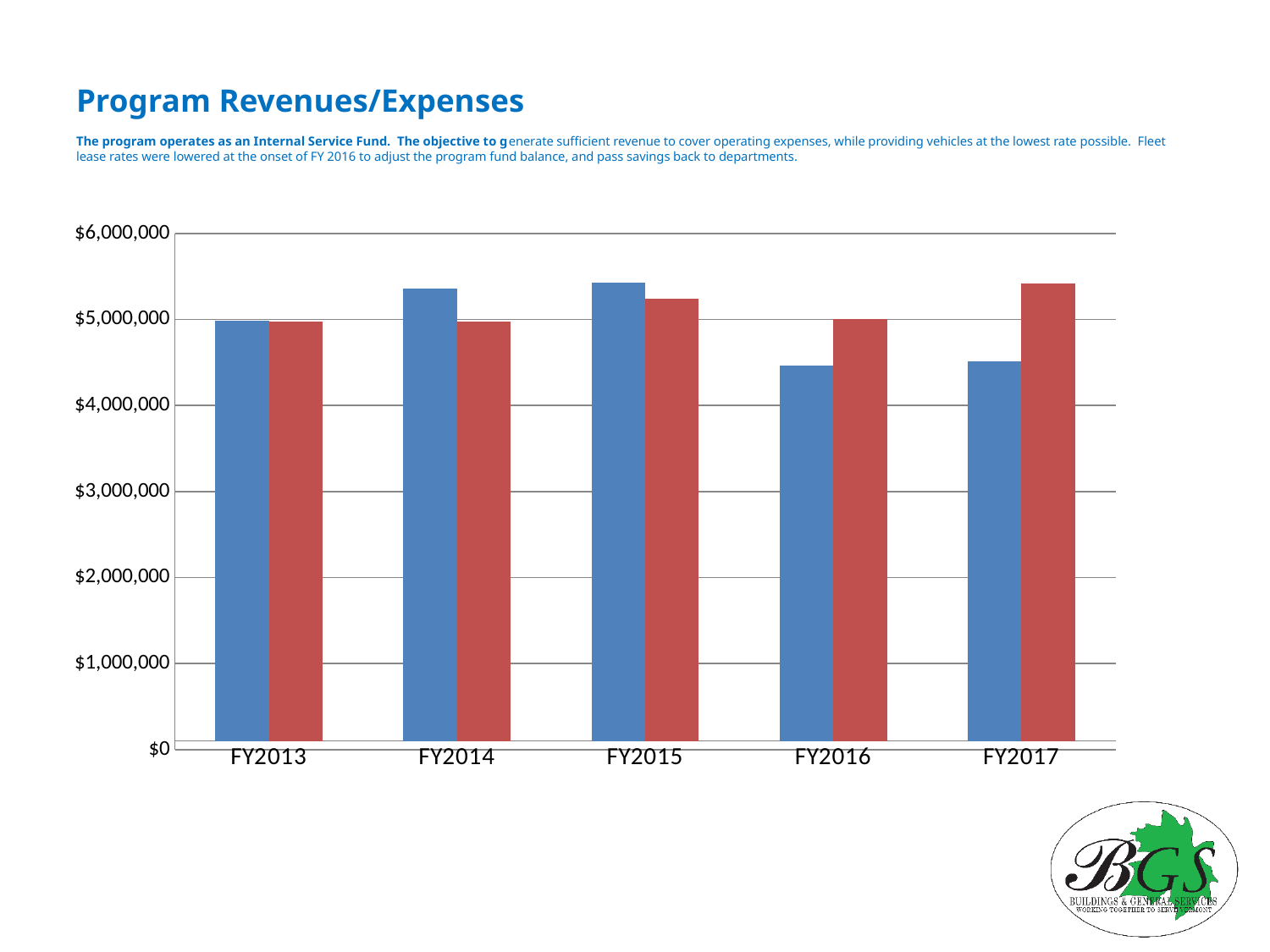
Is the value of the red bar for FY2017 greater or less than $5,000,000? greater What kind of chart is shown on the slide? bar chart In which fiscal year is the red bar the tallest? FY2017 How many fiscal years are shown on the x axis of the chart? 5 What is the title of the slide containing the chart? Program Revenues/Expenses For FY2017, which bar is taller, the blue bar or the red bar? the red bar Is the value of the blue bar for FY2016 greater or less than $5,000,000? less How many bars are plotted for each fiscal year in the chart? 2 Is the value of the red bar for FY2015 greater or less than $6,000,000? less For FY2014, which bar is taller, the blue bar or the red bar? the blue bar Do the blue bars rise or fall from FY2015 to FY2016? fall